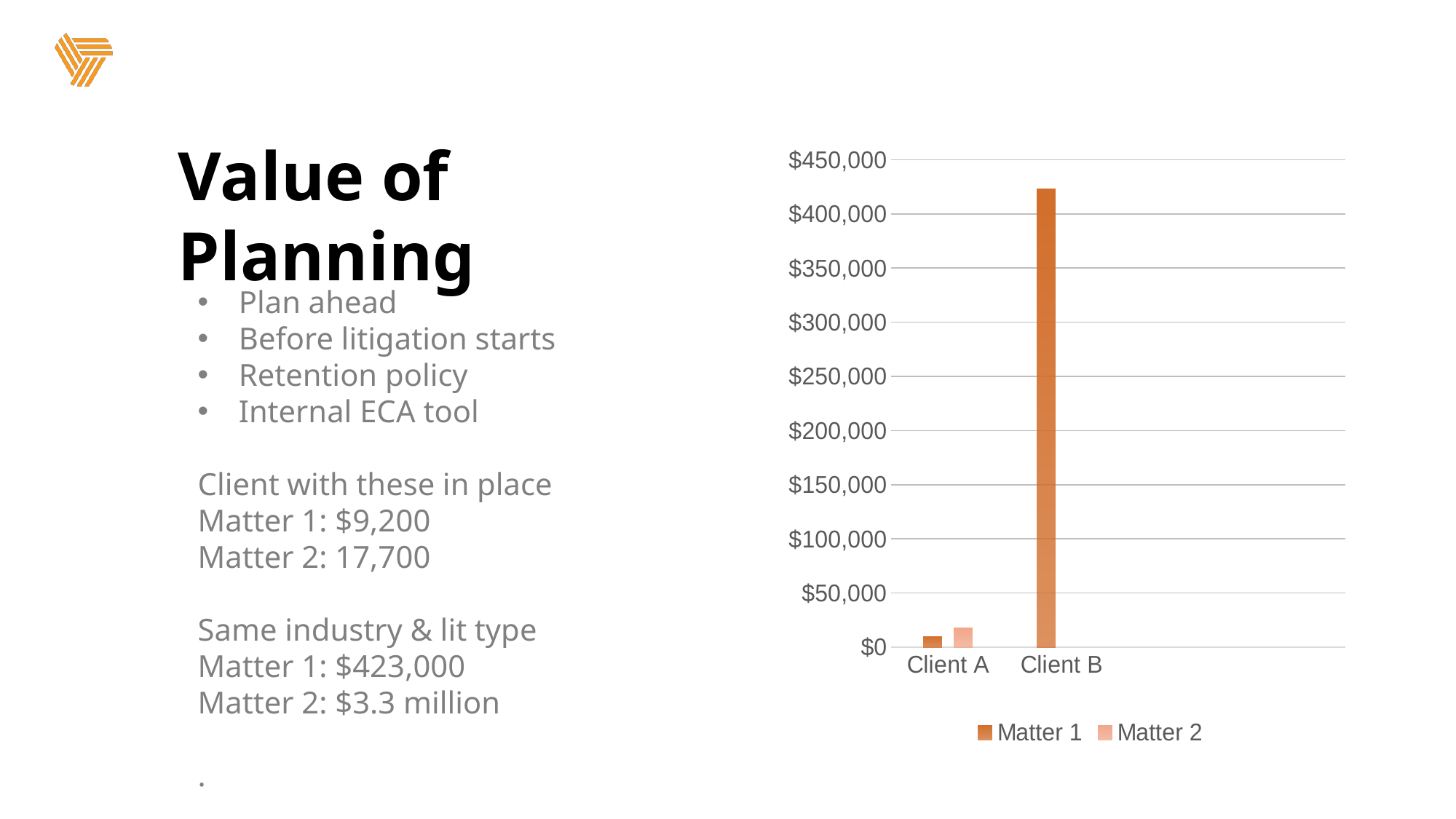
Which bar in the chart is the lowest? Client A, Matter 1 What is the highest value labelled on the chart's vertical axis? $450,000 Is the Matter 1 value for Client B greater or less than $400,000? greater Which client has the highest Matter 1 bar in the chart? Client B For Client A, which is larger: the Matter 1 bar or the Matter 2 bar? Matter 2 Which is larger: the Matter 1 bar for Client A or the Matter 1 bar for Client B? Client B What kind of chart is shown on the slide? bar chart Is the Matter 2 value for Client A greater or less than $50,000? less Is the Matter 1 value for Client A greater or less than $50,000? less How many series does the chart legend list? 2 How many categories are shown on the x axis of the chart? 2 What are the two series named in the chart legend? Matter 1 and Matter 2